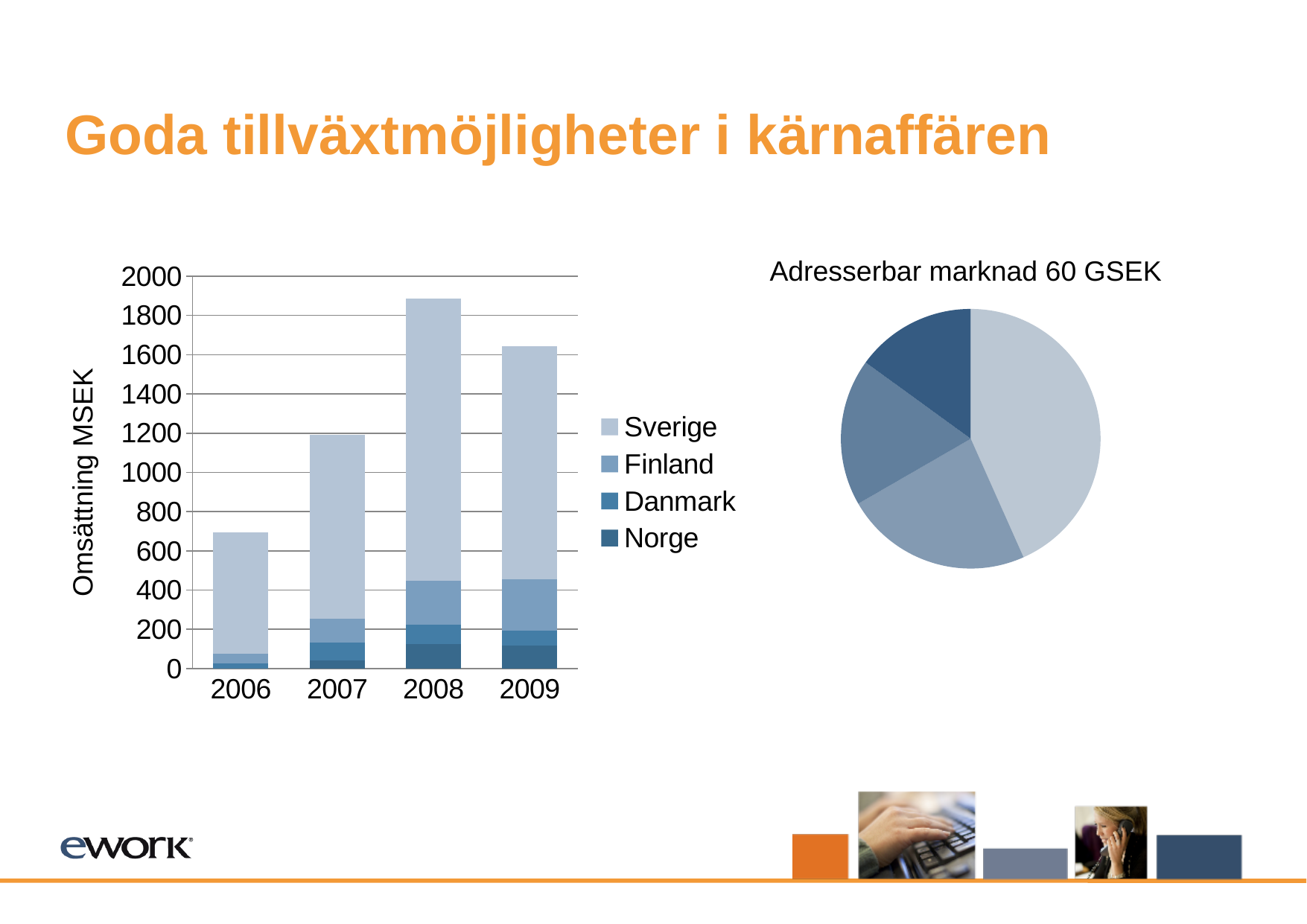
In the bar chart on the left, is the total value for 2009 greater or less than 1800? less In the bar chart on the left, is the total value for 2006 greater or less than 800? less In the bar chart on the left, how many years are shown on the x axis? 4 What kind of chart is the chart on the left of the slide? Stacked bar chart What kind of chart is the chart on the right of the slide, under 'Adresserbar marknad 60 GSEK'? Pie chart In the bar chart on the left, is the total value for 2008 greater or less than 1800? greater In the bar chart on the left, how many series does the legend list? 4 How many slices does the pie chart on the right have? 4 In the bar chart on the left, which year has the highest total bar? 2008 What is the label on the y axis of the bar chart on the left? Omsättning MSEK In the bar chart on the left, is the total bar for 2007 or for 2009 taller? 2009 In the bar chart on the left, which year has the lowest total bar? 2006